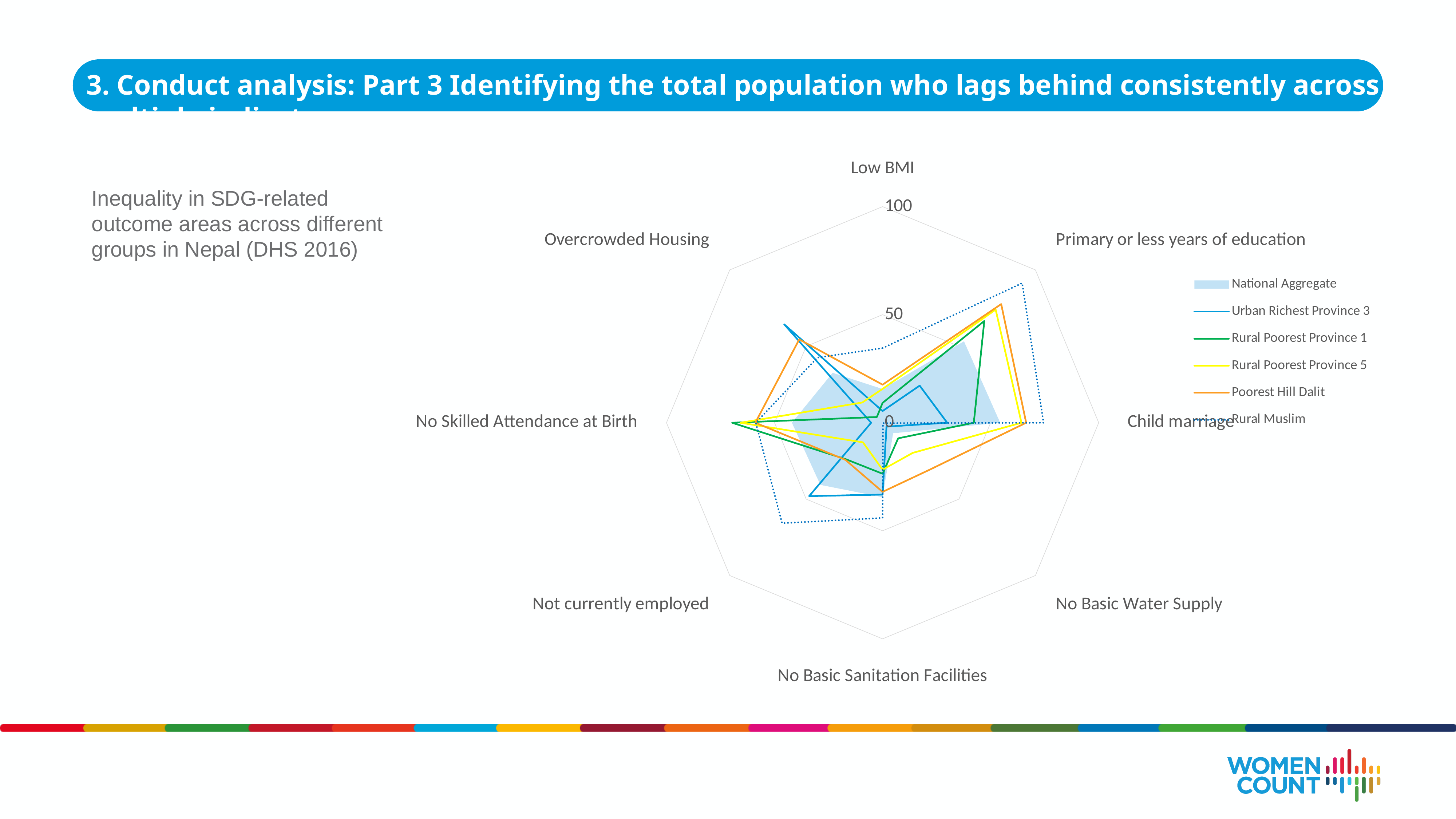
Is the value for Rural Poorest Province 1 on No Skilled Attendance at Birth greater or less than 50? greater On the Child marriage axis, which is larger: Rural Muslim or Urban Richest Province 3? Rural Muslim Is the value for Urban Richest Province 3 on Child marriage greater or less than 50? less Which series has the highest value on the Child marriage axis? Rural Muslim What kind of chart is shown on the slide? Radar chart How many outcome areas (axes) does the radar chart have? 8 How many series does the legend of the radar chart list? 6 Is the value for Rural Muslim on Child marriage greater or less than 50? greater Which series in the legend is drawn as a shaded area rather than a line? National Aggregate What is the maximum value shown on the radar chart's axis scale? 100